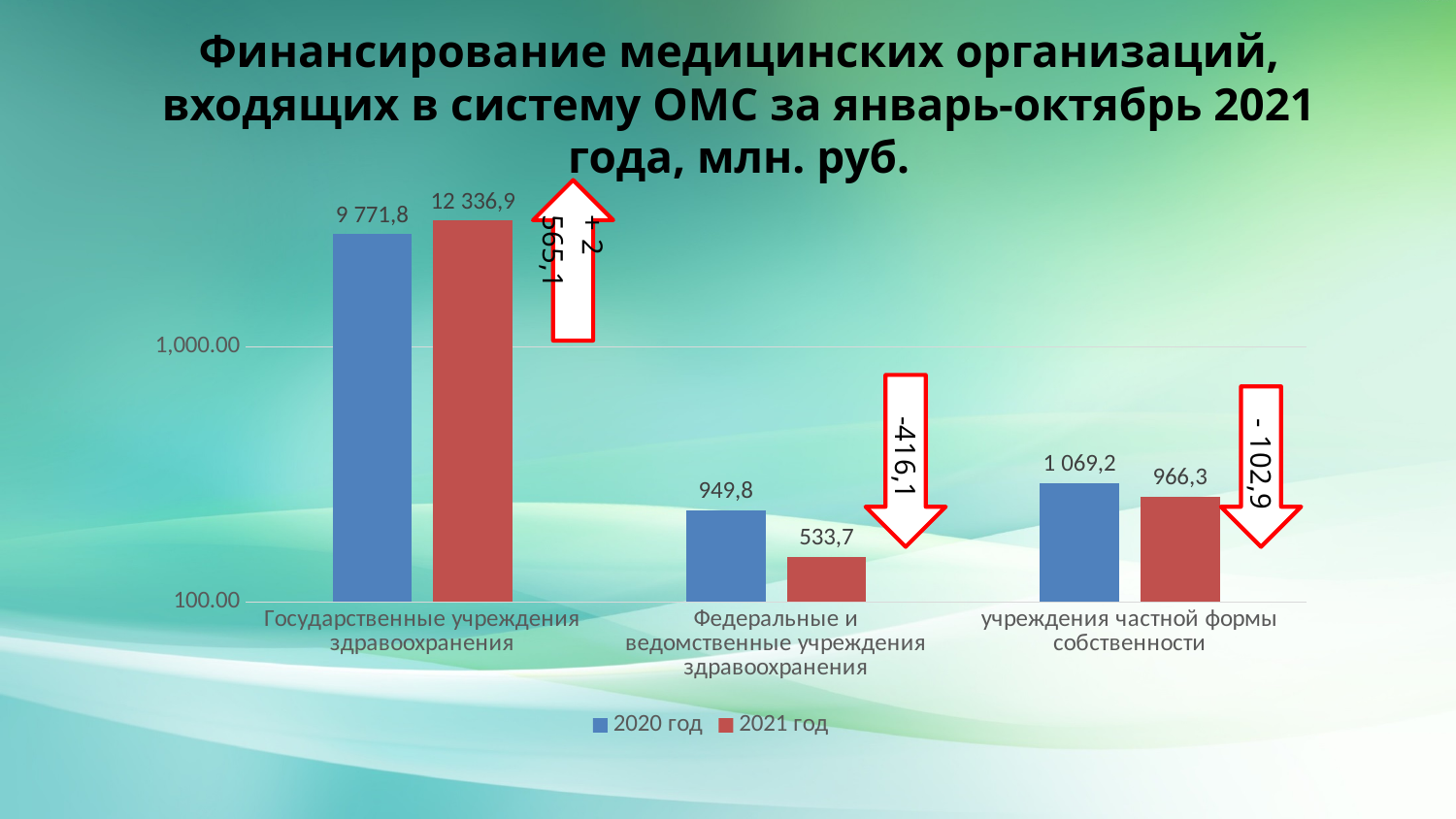
What is the 2021 год value for Федеральные и ведомственные учреждения здравоохранения? 533,7 What is the 2020 год value for учреждения частной формы собственности? 1 069,2 How many series does the legend list? 2 What is the difference between the 2020 год and 2021 год values for Федеральные и ведомственные учреждения здравоохранения? 416,1 What is the value for Государственные учреждения здравоохранения in the 2021 год series? 12 336,9 What is the value for Государственные учреждения здравоохранения in the 2020 год series? 9 771,8 By how much did the value for Государственные учреждения здравоохранения increase from 2020 год to 2021 год? 2 565,1 Which category has the lowest value in the 2020 год series? Федеральные и ведомственные учреждения здравоохранения For учреждения частной формы собственности, which is larger: the 2020 год value or the 2021 год value? 2020 год Is the 2021 год value for Федеральные и ведомственные учреждения здравоохранения greater or less than 1,000.00? less Which category has the highest value in the 2021 год series? Государственные учреждения здравоохранения How many categories are shown on the x axis? 3